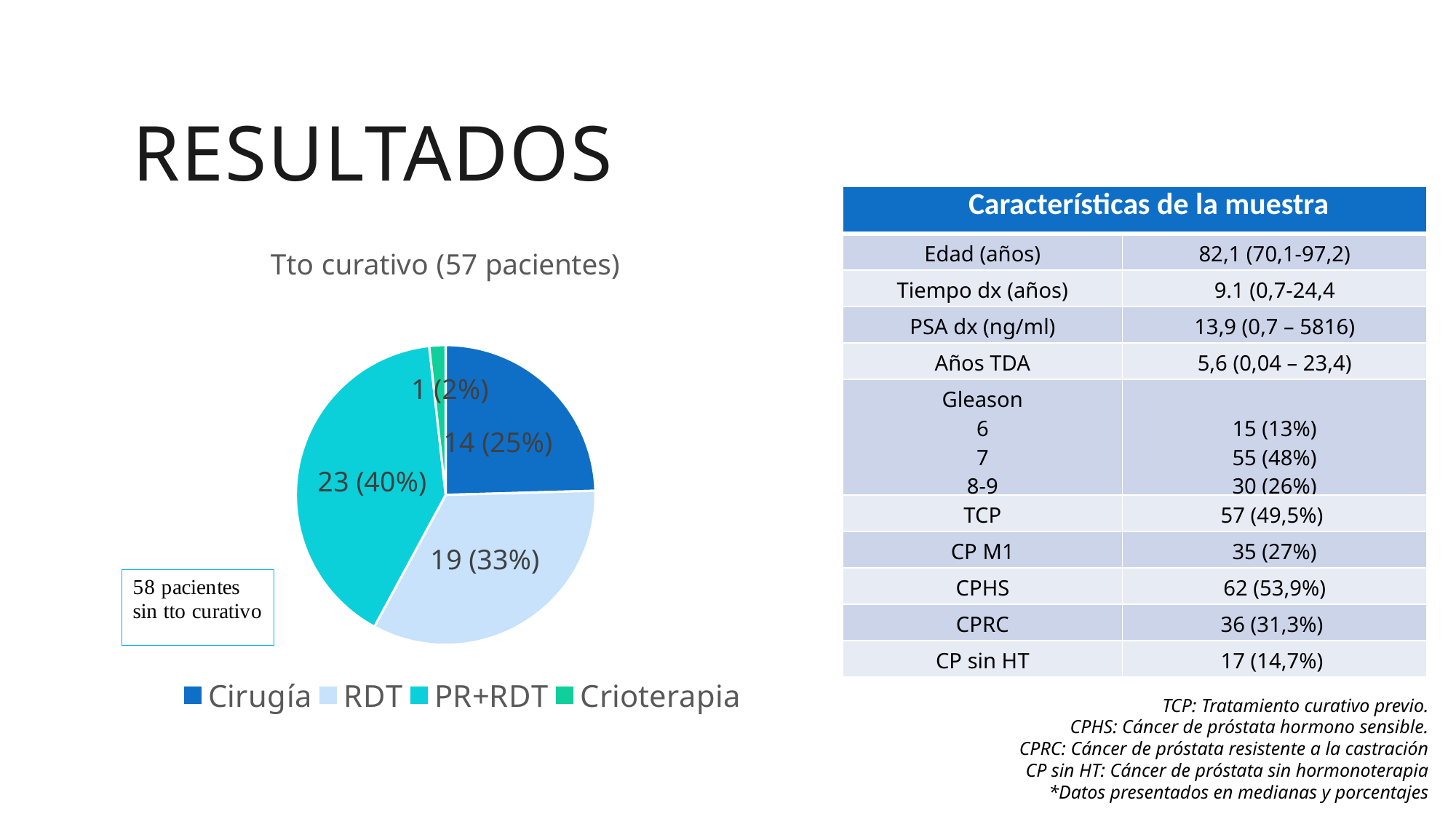
What is the title of the pie chart? Tto curativo (57 pacientes) What kind of chart is shown on the slide? pie chart What is the value shown for Crioterapia in the pie chart? 1 (2%) What is the value shown for Cirugía in the pie chart? 14 (25%) What share of the pie does RDT represent? 33% What is the value shown for RDT in the pie chart? 19 (33%) What is the difference in patient count between PR+RDT and Cirugía in the pie chart? 9 How many slices does the pie chart have? 4 How many entries does the legend of the pie chart list? 4 Which category has the smallest slice in the pie chart? Crioterapia Which category has the largest slice in the pie chart? PR+RDT What is the value shown for PR+RDT in the pie chart? 23 (40%)